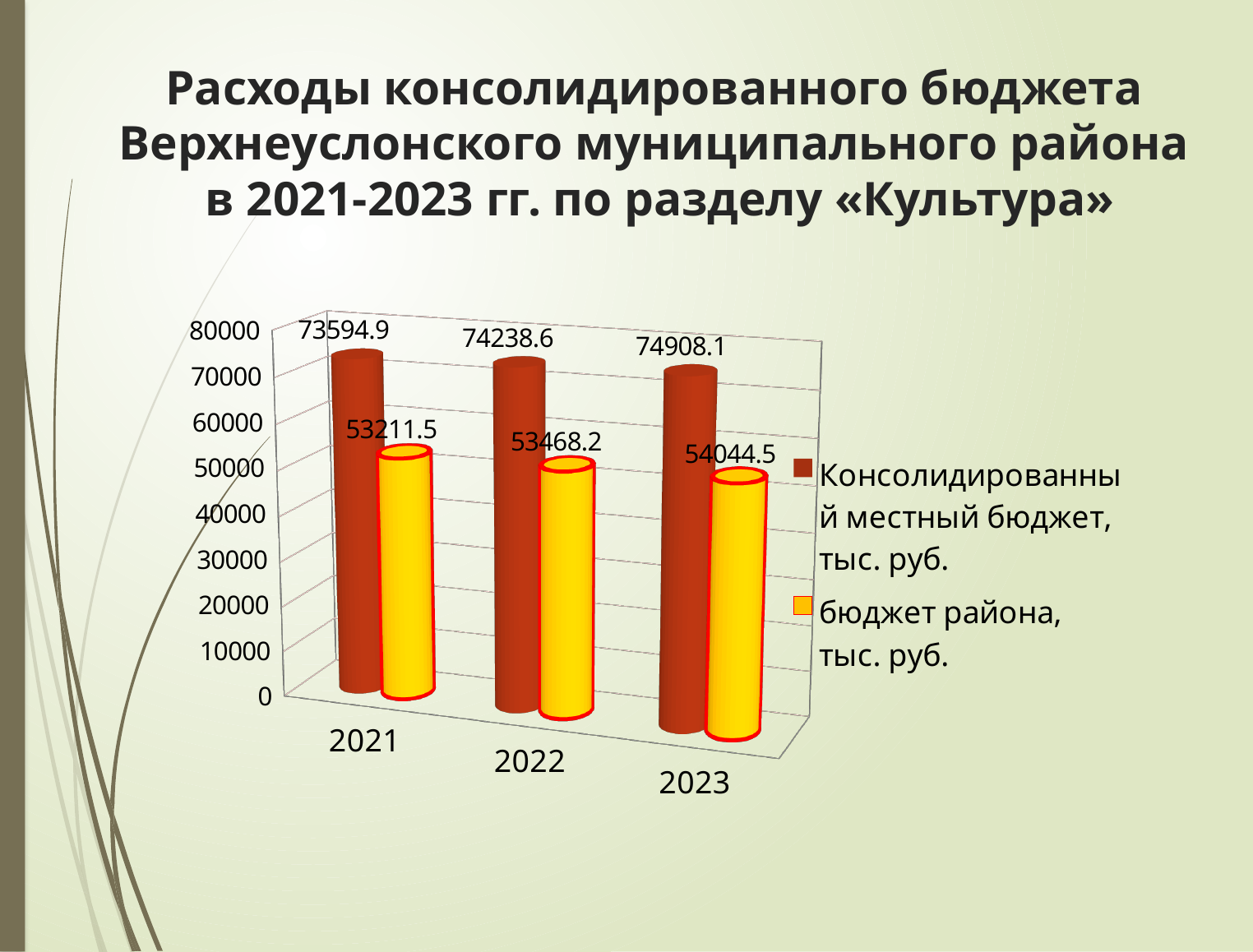
Do the consolidated local budget values rise or fall from 2021 to 2023? rise What is the difference between the consolidated local budget in 2023 and in 2021? 1313.2 In which year is the district budget lowest? 2021 What is the value of the district budget (бюджет района) for 2023? 54044.5 Is the district budget value for 2023 greater or less than 60000? less How many years are shown on the x axis? 3 What is the value of the district budget (бюджет района) for 2022? 53468.2 What is the value of the consolidated local budget (Консолидированный местный бюджет) for 2021? 73594.9 In which year is the consolidated local budget highest? 2023 Which is larger in 2022: the consolidated local budget or the district budget? Consolidated local budget How many series does the legend list? 2 What is the difference between the consolidated local budget and the district budget in 2021? 20383.4